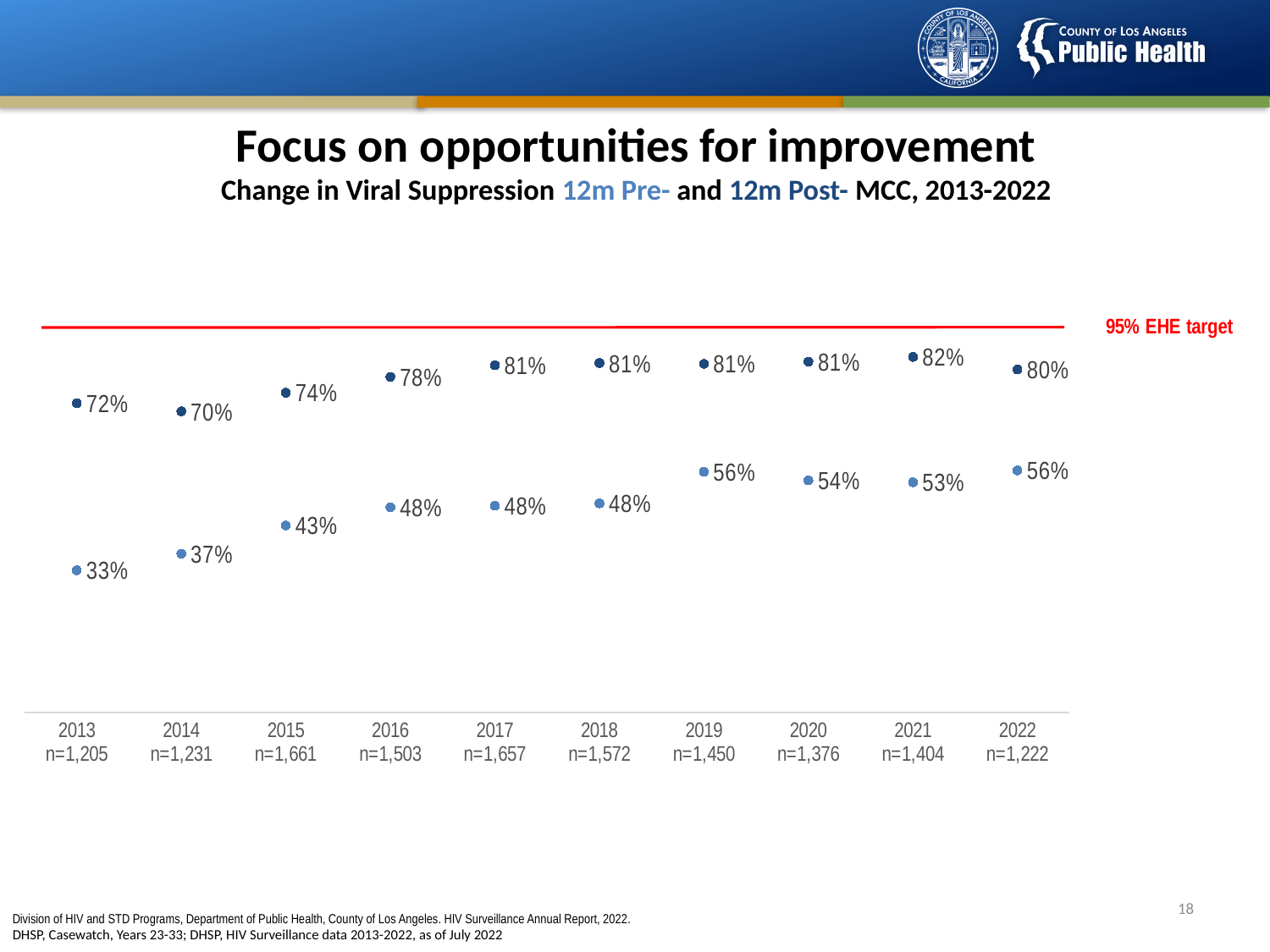
Which year has the highest 12m Post- MCC viral suppression value? 2021 What is the sample size (n) shown for 2015? n=1,661 What is the 12m Post- MCC viral suppression value for 2021? 82% What is the difference between the 12m Post- and 12m Pre- MCC values in 2013? 39 percentage points Which year has the lowest 12m Pre- MCC viral suppression value? 2013 What target value is marked by the red horizontal line on the chart? 95% EHE target What is the 12m Post- MCC viral suppression value for 2013? 72% How many years are shown on the x axis of the chart? 10 What is the 12m Pre- MCC viral suppression value for 2022? 56% Is the 12m Pre- MCC value for 2019 larger or smaller than the value for 2020? larger What is the 12m Pre- MCC viral suppression value for 2013? 33% What is the difference between the 12m Pre- MCC values for 2022 and 2013? 23 percentage points